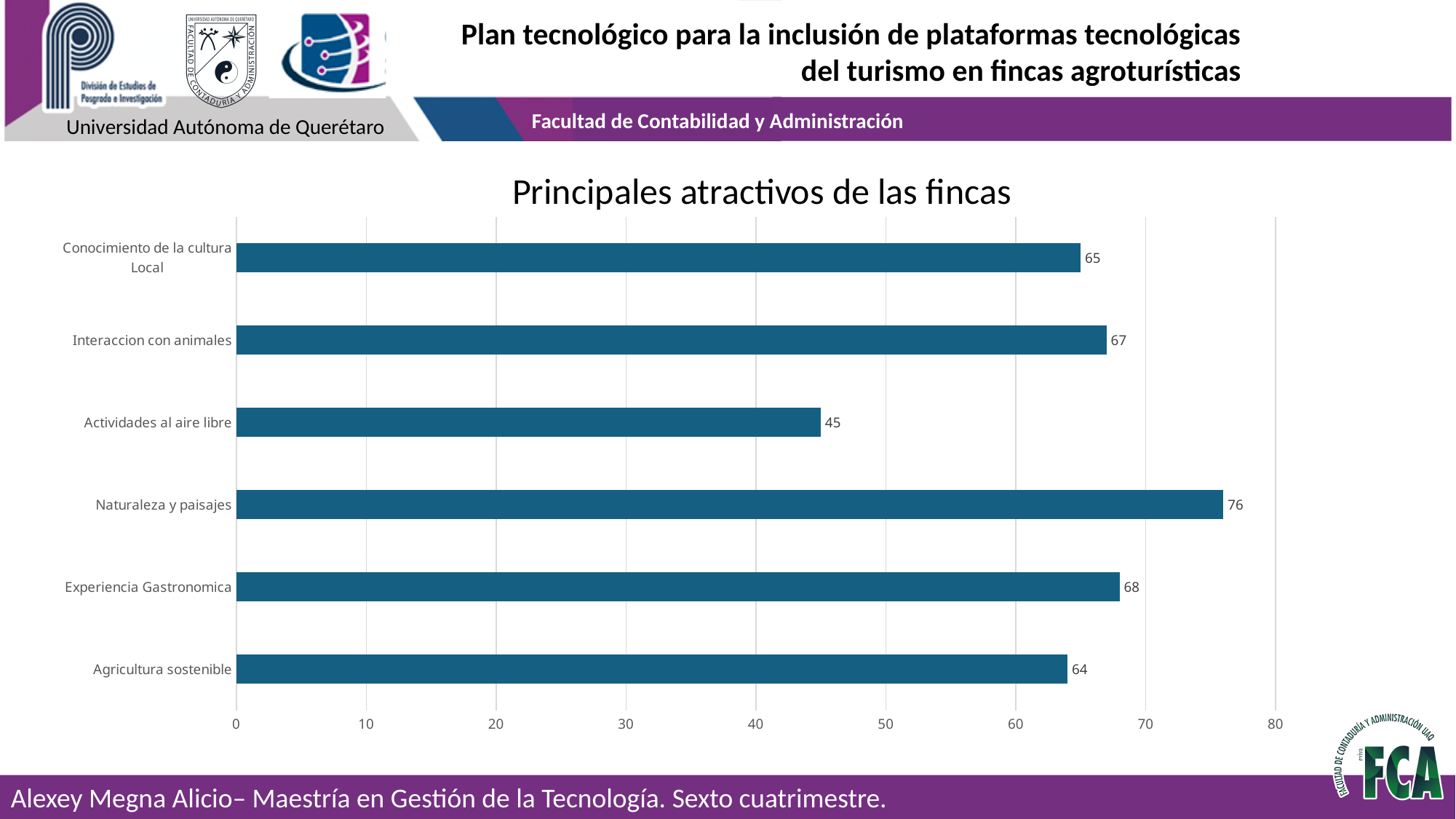
What is the difference between the values for Naturaleza y paisajes and Actividades al aire libre? 31 Is the value for Actividades al aire libre greater or less than 50? less What type of chart is shown on the slide? Bar chart Which category has the highest value? Naturaleza y paisajes Which category has the lowest value? Actividades al aire libre What is the difference between the values for Experiencia Gastronomica and Agricultura sostenible? 4 What is the value for Agricultura sostenible? 64 How many categories are shown in the chart? 6 What is the value for Naturaleza y paisajes? 76 What is the value for Actividades al aire libre? 45 Which is larger, the value for Experiencia Gastronomica or the value for Conocimiento de la cultura Local? Experiencia Gastronomica What is the value for Interaccion con animales? 67